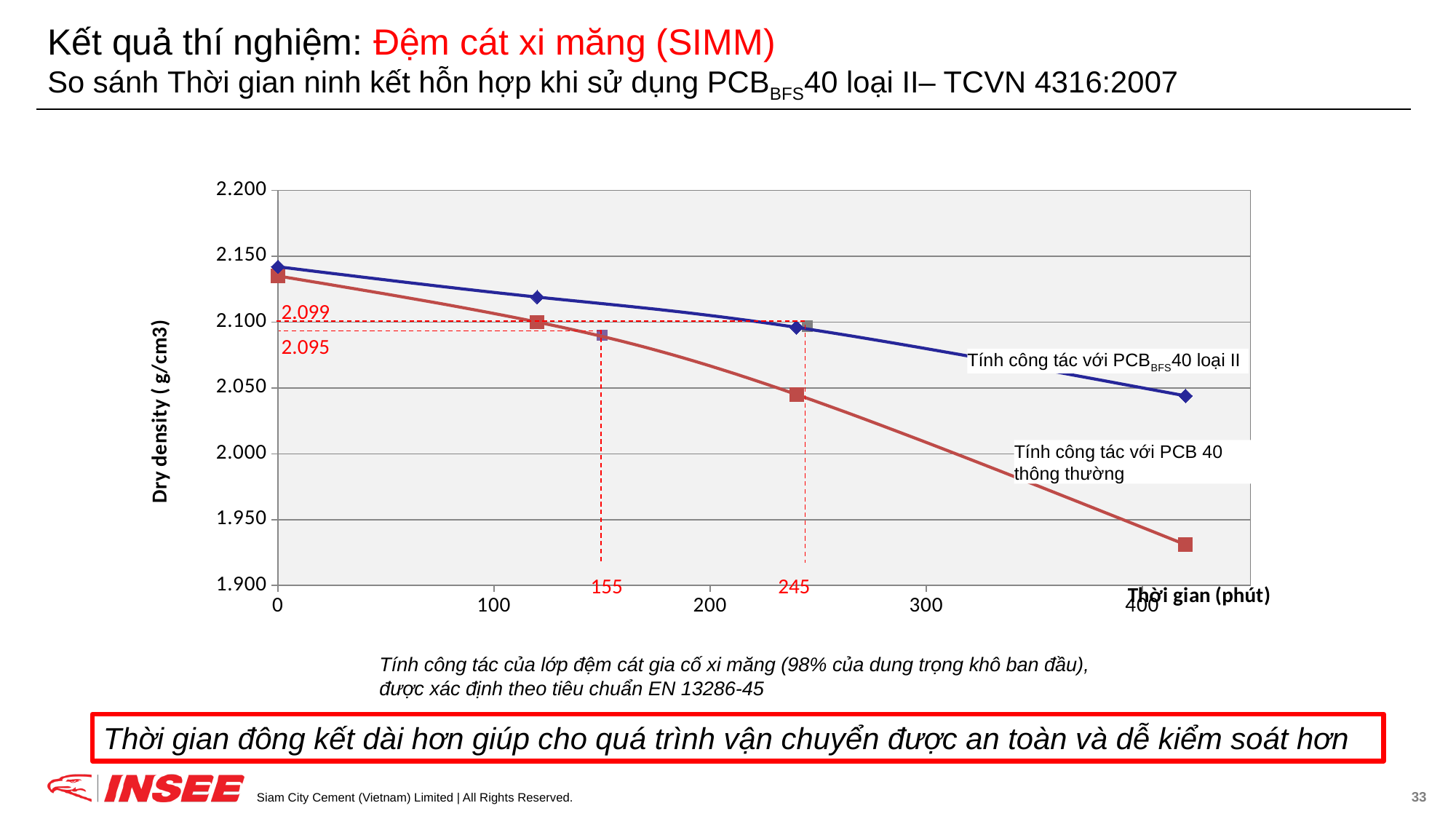
What time value (in minutes) is marked by the dashed vertical line where the PCB BFS40 loại II curve crosses the workability limit? 245 Which series has the higher dry density at the last plotted time point (around 400 minutes): PCB BFS40 loại II or PCB 40 thông thường? PCB BFS40 loại II Does the dry density for the 'Tính công tác với PCB 40 thông thường' series rise or fall as time increases? fall Does the dry density for the 'Tính công tác với PCB BFS40 loại II' series rise or fall as time increases? fall Is the dry density of the PCB BFS40 loại II series at time 0 greater or less than 2.100? greater Is the dry density of the PCB 40 thông thường series at its last plotted point (around 400 minutes) greater or less than 1.950? less What is the title of the horizontal axis of the chart? Thời gian (phút) What time value (in minutes) is marked by the dashed vertical line where the PCB 40 thông thường curve crosses the workability limit? 155 What is the title of the vertical axis of the chart? Dry density ( g/cm3) What kind of chart is shown on the slide? line chart What are the two dry density values annotated on the dashed horizontal lines of the chart? 2.099 and 2.095 How many data series (lines) are plotted on the chart? 2